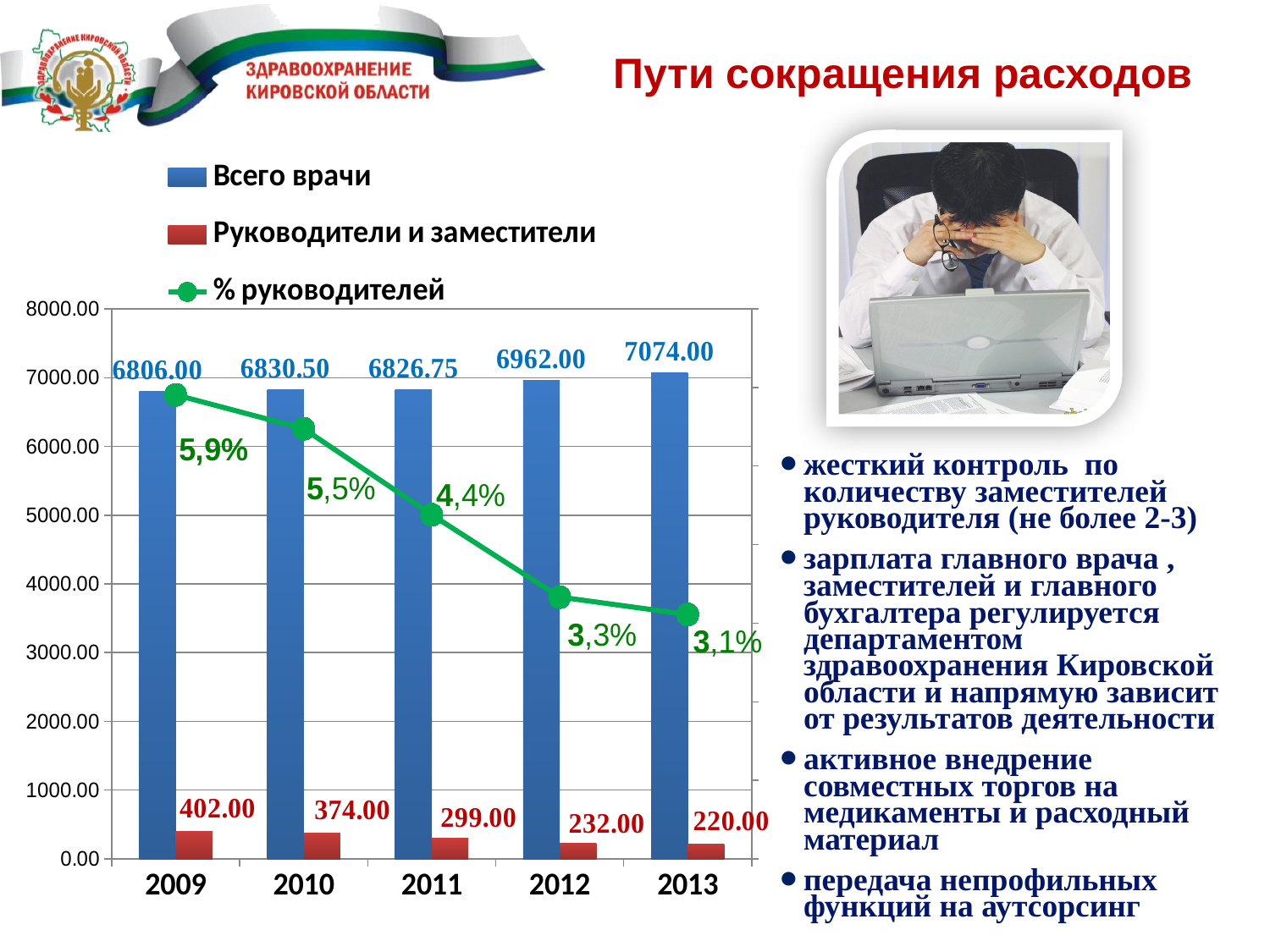
In which year is "Руководители и заместители" lowest? 2013 What is the difference between "Руководители и заместители" in 2009 and 2013? 182.00 Does the "% руководителей" line rise or fall from 2009 to 2013? fall How many series does the legend list? 3 What is the "% руководителей" value for 2011? 4,4% In which year is "Всего врачи" highest? 2013 Which is larger: "Всего врачи" in 2012 or in 2011? 2012 What is the value of "Руководители и заместители" for 2009? 402.00 How many years are shown on the x axis? 5 What colour are the "Всего врачи" bars? blue Is the value for "Всего врачи" in 2010 greater or less than 6000.00? greater What is the value of "Всего врачи" for 2013? 7074.00